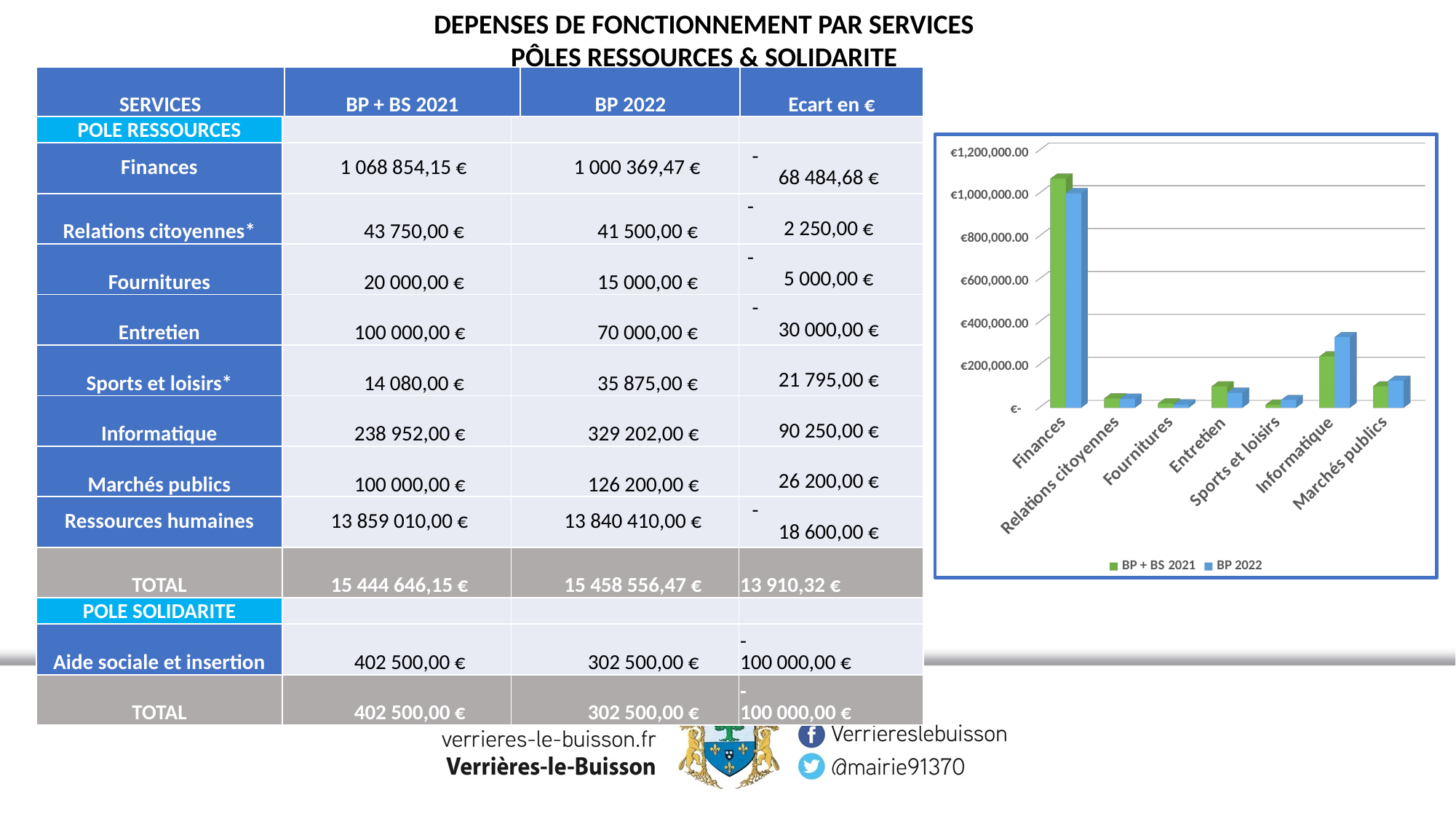
For Finances, which series is larger in the chart: BP + BS 2021 or BP 2022? BP + BS 2021 According to the table on the slide, what is the BP 2022 value for Entretien? 70 000,00 € What kind of chart is shown on the right of the slide? bar chart In the chart, is the BP + BS 2021 value for Finances greater or less than €800,000.00? greater For Informatique, which series is larger in the chart: BP + BS 2021 or BP 2022? BP 2022 In the chart, is the BP 2022 value for Informatique greater or less than €200,000.00? greater How many service categories are plotted on the x axis of the chart? 7 Which category has the highest BP 2022 value in the chart? Finances Which category has the highest BP + BS 2021 value in the chart? Finances Which colour represents the BP 2022 series in the chart? blue How many series does the chart legend list? 2 In the chart, is the BP + BS 2021 value for Entretien greater or less than €200,000.00? less